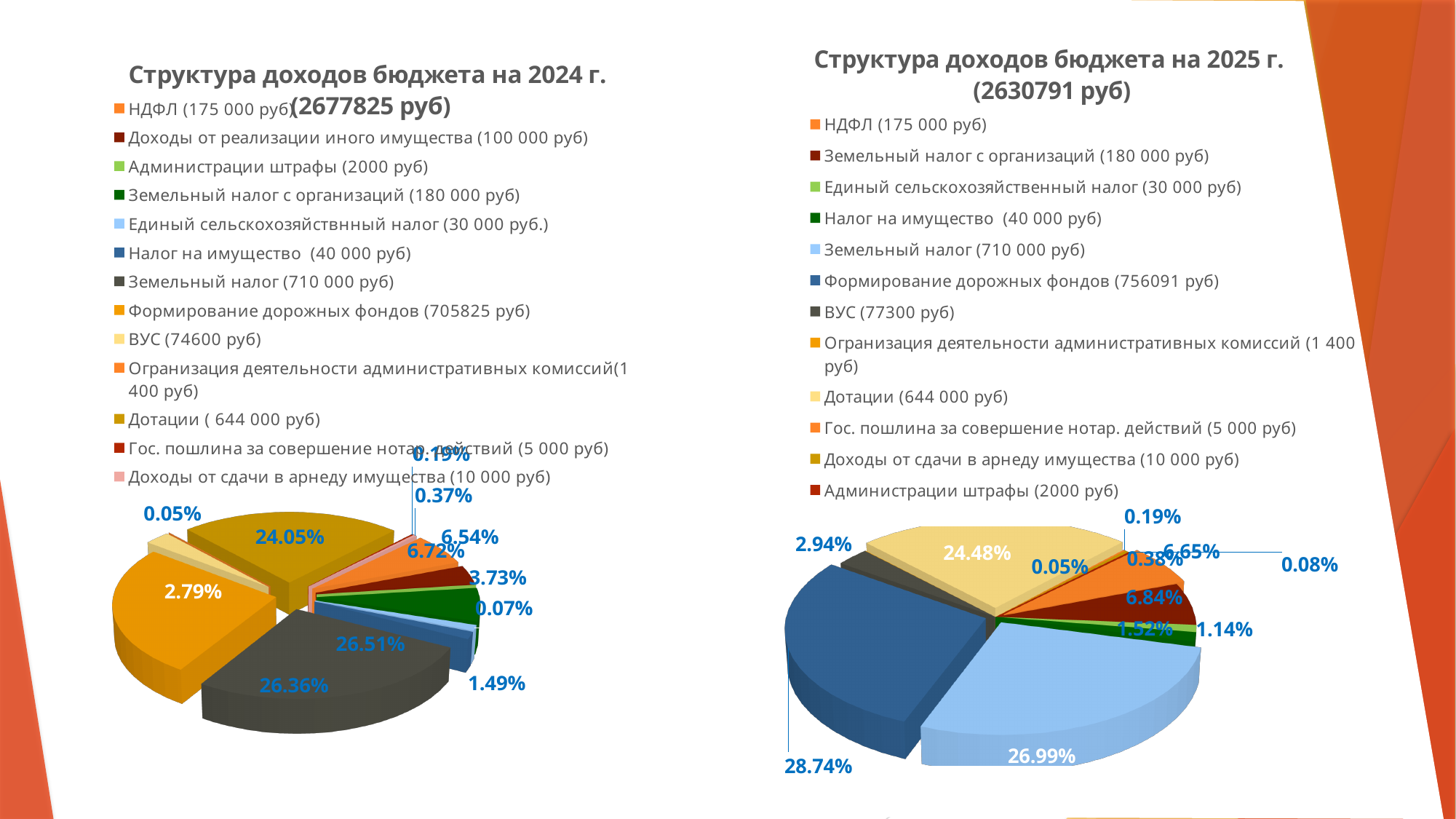
In the right chart (2025), which is larger: Земельный налог с организаций or Налог на имущество? Земельный налог с организаций What is the difference between the amount for Формирование дорожных фондов in the 2025 chart and in the 2024 chart? 50266 руб In the right chart (2025), what share of the pie does Дотации have? 24.48% In the right chart (2025), which category has the largest slice? Формирование дорожных фондов According to the legend of the right chart (2025), what is the amount for ВУС? 77300 руб What kind of chart is used on the left side of the slide (Структура доходов бюджета на 2024 г.)? Pie chart In the left chart (2024), what share of the pie does Дотации have? 24.05% In the right chart (2025), what share of the pie does Земельный налог have? 26.99% What total budget revenue is stated in the title of the left chart for 2024? 2677825 руб According to the legend of the left chart (2024), what is the amount for Формирование дорожных фондов? 705825 руб How many categories does the legend of the right chart (Структура доходов бюджета на 2025 г.) list? 12